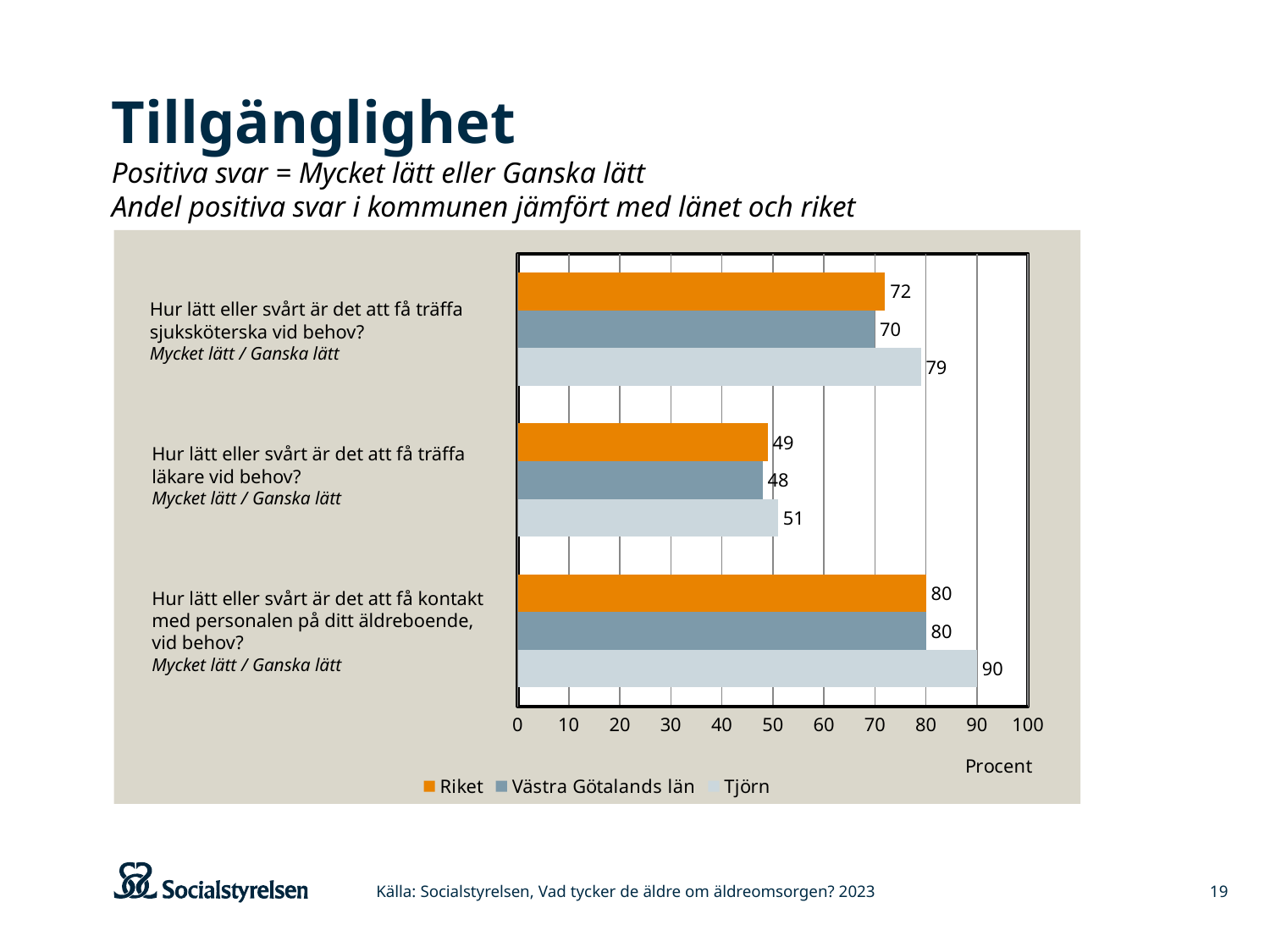
Is the value for Tjörn on the question about contact with staff at the care home greater or less than 80? greater Which question has the highest value for Tjörn? Hur lätt eller svårt är det att få kontakt med personalen på ditt äldreboende, vid behov? Which is larger on the question about meeting a doctor: the value for Tjörn or the value for Riket? Tjörn Which question has the lowest value for Riket? Hur lätt eller svårt är det att få träffa läkare vid behov? What is the value for Tjörn on the question about getting in contact with staff at the care home ("få kontakt med personalen på ditt äldreboende")? 90 What kind of chart is shown on the slide? Bar chart What is the value for Riket on the question about meeting a nurse when needed ("få träffa sjuksköterska vid behov")? 72 How many questions (categories) are shown in the chart? 3 Which series is shown in orange in the legend? Riket How many series does the legend list? 3 What is the value for Västra Götalands län on the question about meeting a doctor when needed ("få träffa läkare vid behov")? 48 What is the difference between Tjörn and Riket on the question about meeting a nurse when needed? 7